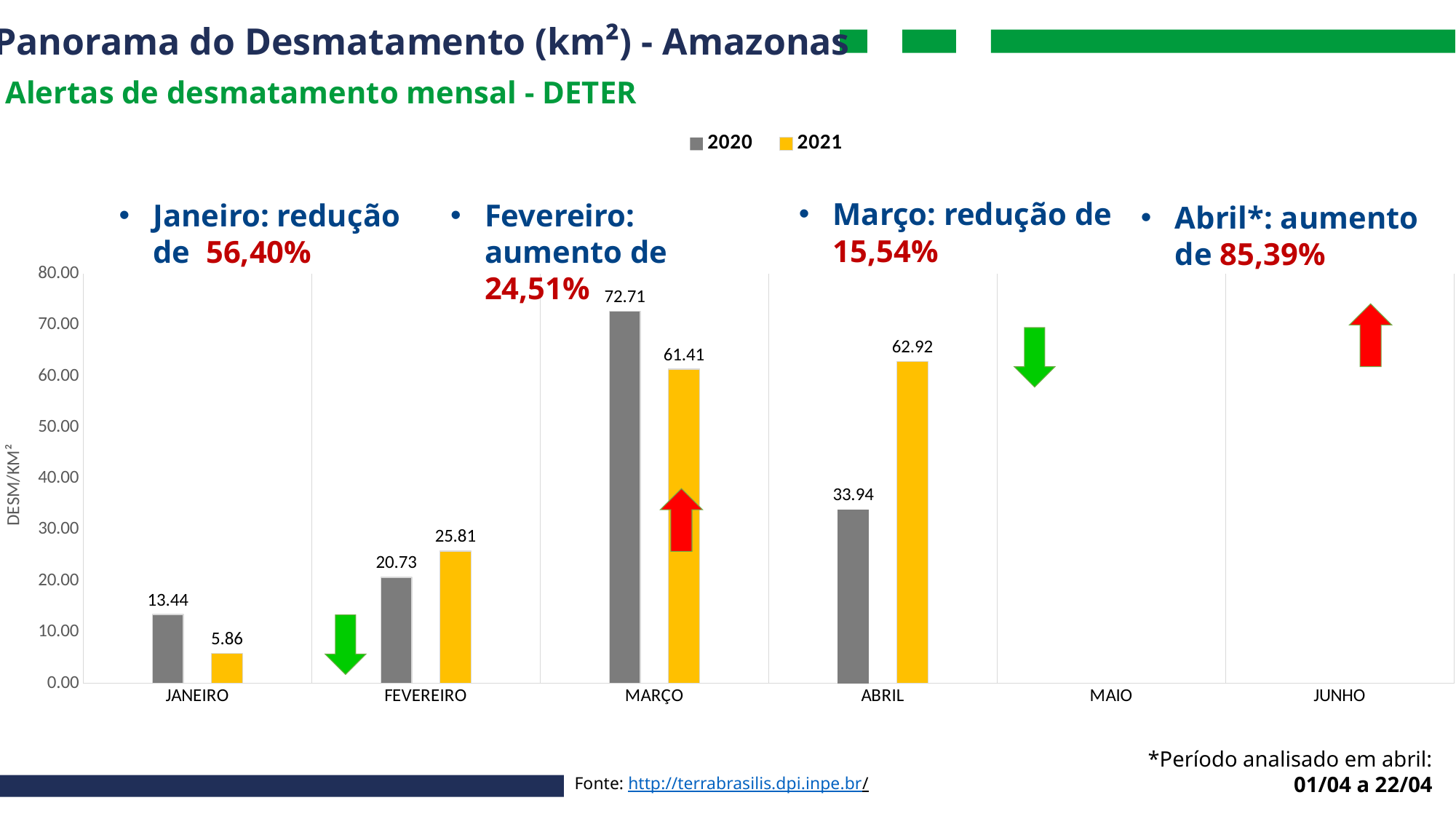
What kind of chart is shown on the slide? bar chart How many series does the legend list? 2 What is the 2020 value for FEVEREIRO? 20.73 What is the label of the vertical axis? DESM/KM² What is the 2021 value for ABRIL? 62.92 How many month categories are shown on the x axis? 6 What is the 2021 value for JANEIRO? 5.86 What is the 2020 value for MARÇO? 72.71 Which month has the highest 2020 value? MARÇO Which is larger for FEVEREIRO, the 2020 value or the 2021 value? 2021 Which month has the lowest 2021 value? JANEIRO What is the difference between the 2020 and 2021 values for ABRIL? 28.98